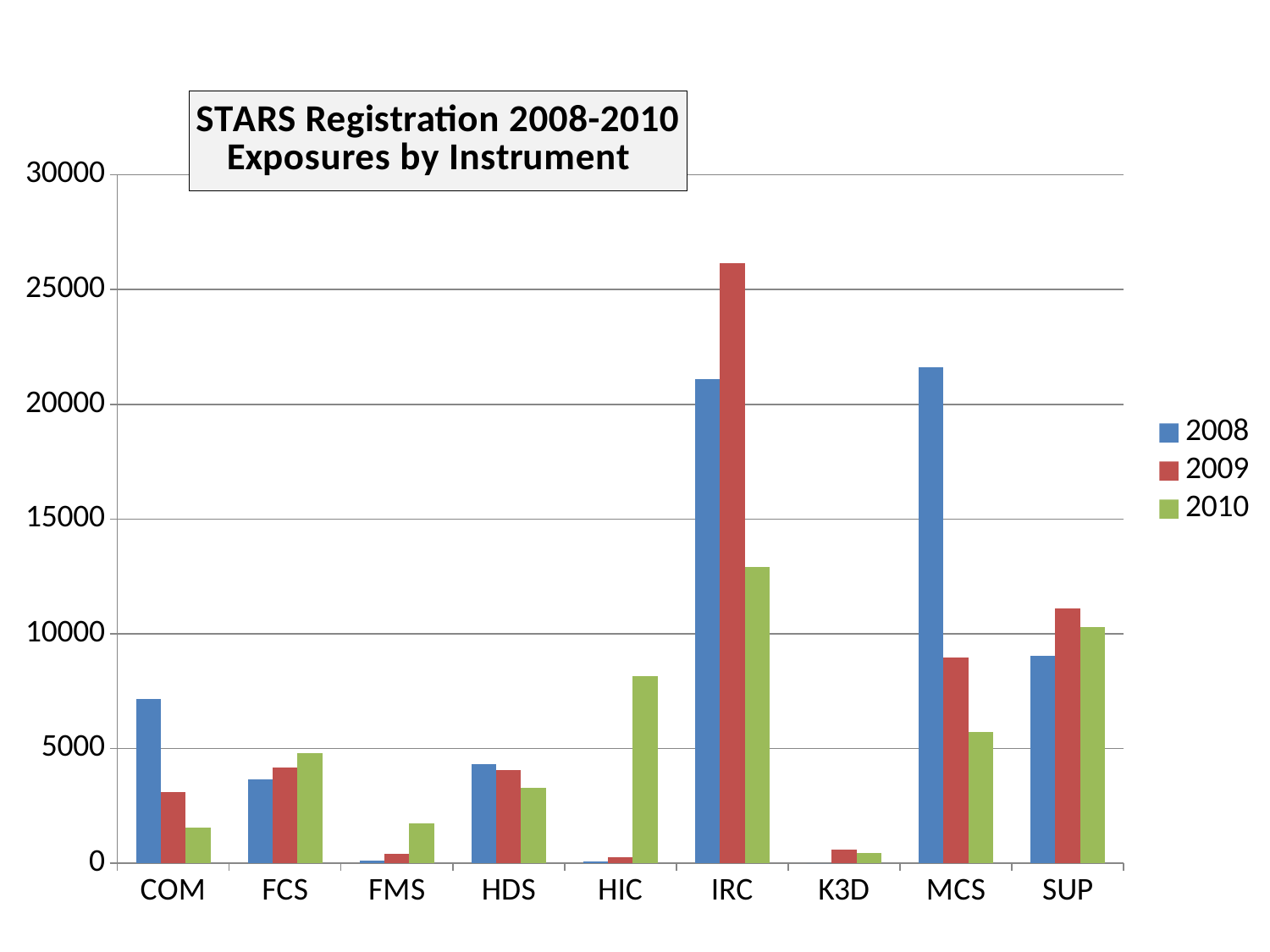
Do the values for COM rise or fall from 2008 to 2010? fall What kind of chart is shown on the slide? bar chart How many instrument categories are shown on the x axis? 9 Which instrument has the lowest value for 2010? K3D What is the title of the chart? STARS Registration 2008-2010 Exposures by Instrument Is the 2009 value for IRC greater or less than 25000? greater For HIC, which year has the larger value, 2008 or 2010? 2010 How many series does the legend list? 3 Which instrument has the highest value for 2010? IRC Is the 2008 value for MCS greater or less than 20000? greater For COM, which year has the larger value, 2008 or 2009? 2008 Which instrument has the highest value for 2009? IRC